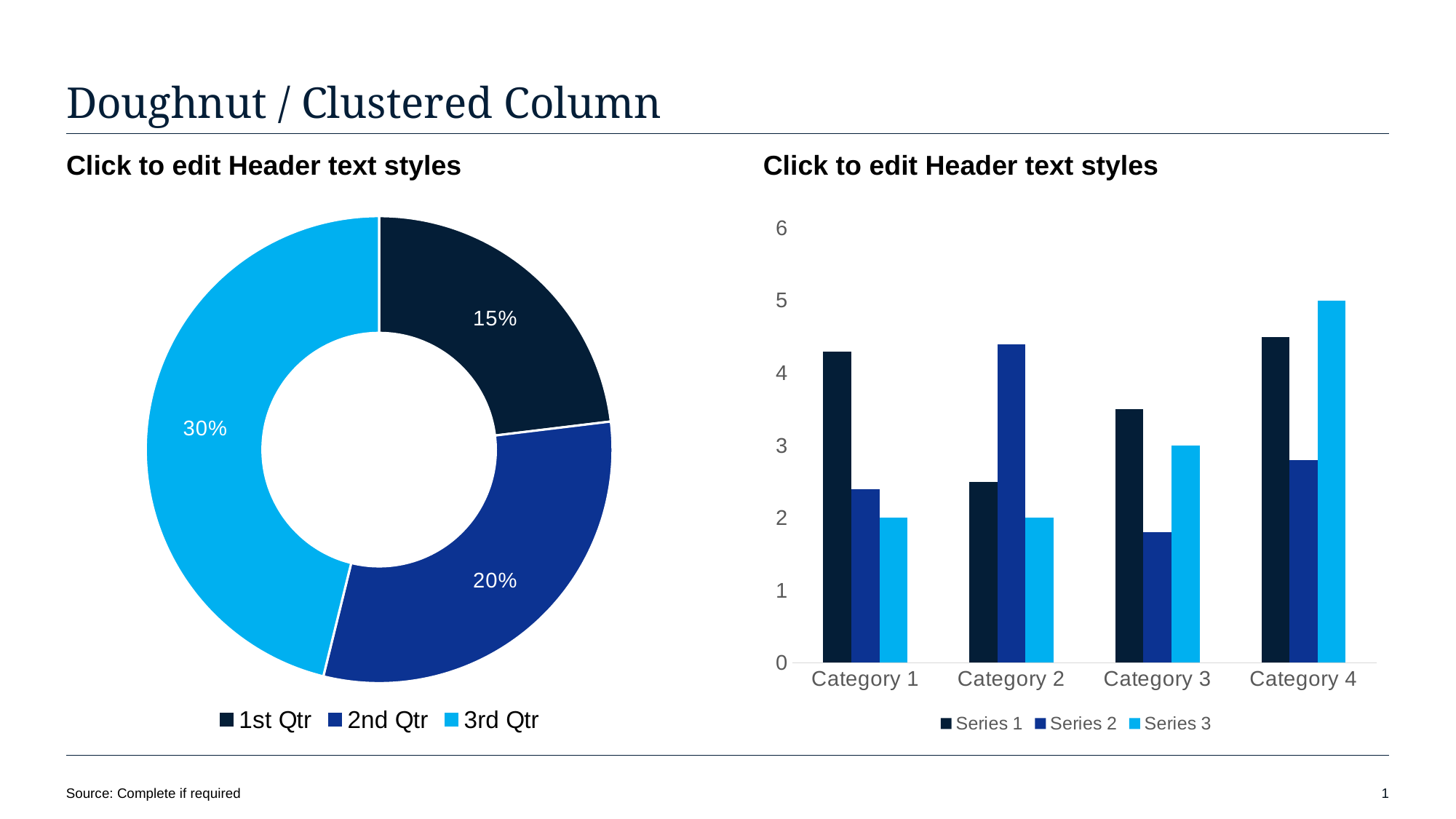
On the doughnut chart on the left, what is the value for 1st Qtr? 15% On the doughnut chart on the left, what is the difference between the 3rd Qtr and 1st Qtr values? 15% On the bar chart on the right, in which category is Series 3 highest? Category 4 On the doughnut chart on the left, how many slices are there? 3 On the bar chart on the right, how many categories are shown on the x axis? 4 On the bar chart on the right, is the value for Series 1 in Category 1 greater or less than 4? greater On the doughnut chart on the left, what is the value for 3rd Qtr? 30% On the bar chart on the right, is the value for Series 2 in Category 3 greater or less than 2? less On the doughnut chart on the left, which quarter has the smallest slice? 1st Qtr On the doughnut chart on the left, which quarter has the largest slice? 3rd Qtr On the bar chart on the right, how many series does the legend list? 3 What kind of chart is shown on the right side of the slide? Bar chart